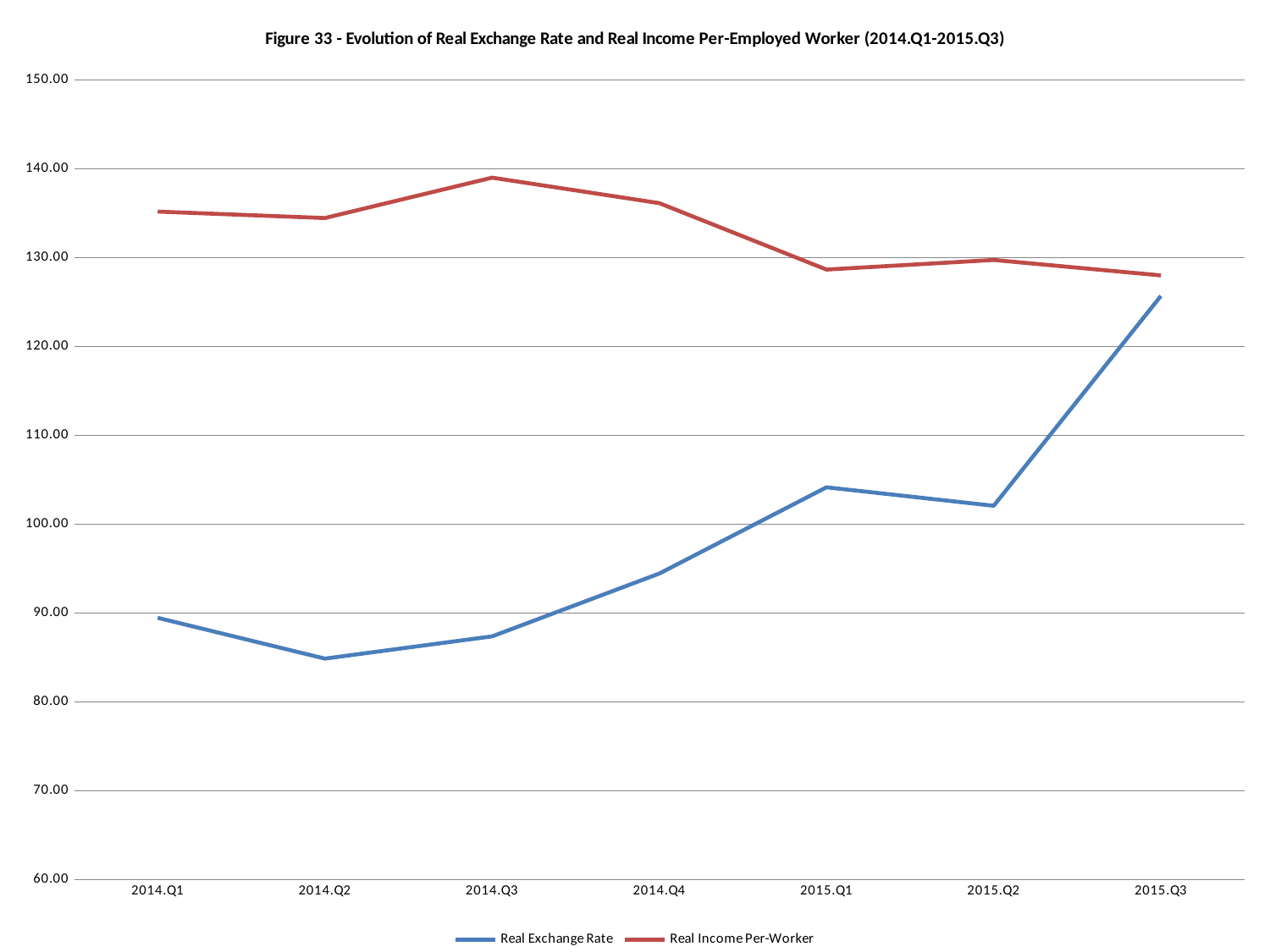
Which colour is used for the Real Income Per-Worker line? Red How many series does the legend list? 2 In 2014.Q1, which series has the higher value, Real Exchange Rate or Real Income Per-Worker? Real Income Per-Worker Is the Real Exchange Rate in 2014.Q2 greater or less than 90.00? less In which quarter is the Real Exchange Rate at its lowest? 2014.Q2 Is the Real Exchange Rate in 2015.Q3 greater or less than 120.00? greater In which quarter does the Real Exchange Rate reach its highest value? 2015.Q3 Is Real Income Per-Worker in 2015.Q1 greater or less than 130.00? less In which quarter does Real Income Per-Worker reach its highest value? 2014.Q3 What type of chart is shown on the slide? Line chart Does the Real Exchange Rate generally rise or fall from 2014.Q1 to 2015.Q3? Rise How many quarters are plotted along the x axis? 7